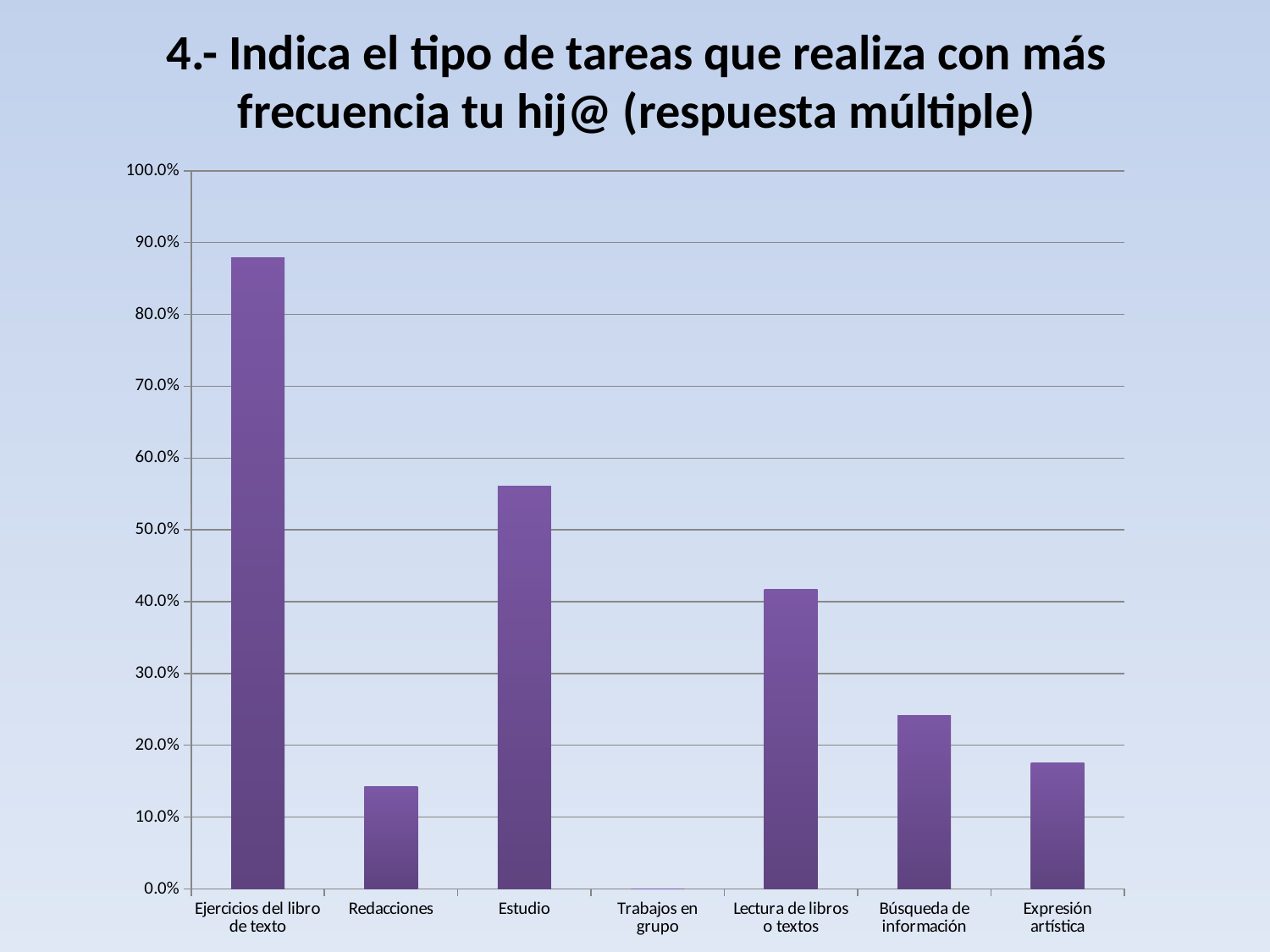
Is the value for Expresión artística greater or less than 20.0%? less What is the title of the chart? 4.- Indica el tipo de tareas que realiza con más frecuencia tu hij@ (respuesta múltiple) Is the value for Ejercicios del libro de texto greater or less than 80.0%? greater What kind of chart is shown on the slide? Bar chart Is the value for Estudio greater or less than 50.0%? greater Which task category has the lowest value? Trabajos en grupo Which task category has the highest value? Ejercicios del libro de texto Which is larger, the value for Estudio or the value for Lectura de libros o textos? Estudio How many task categories are shown on the x axis? 7